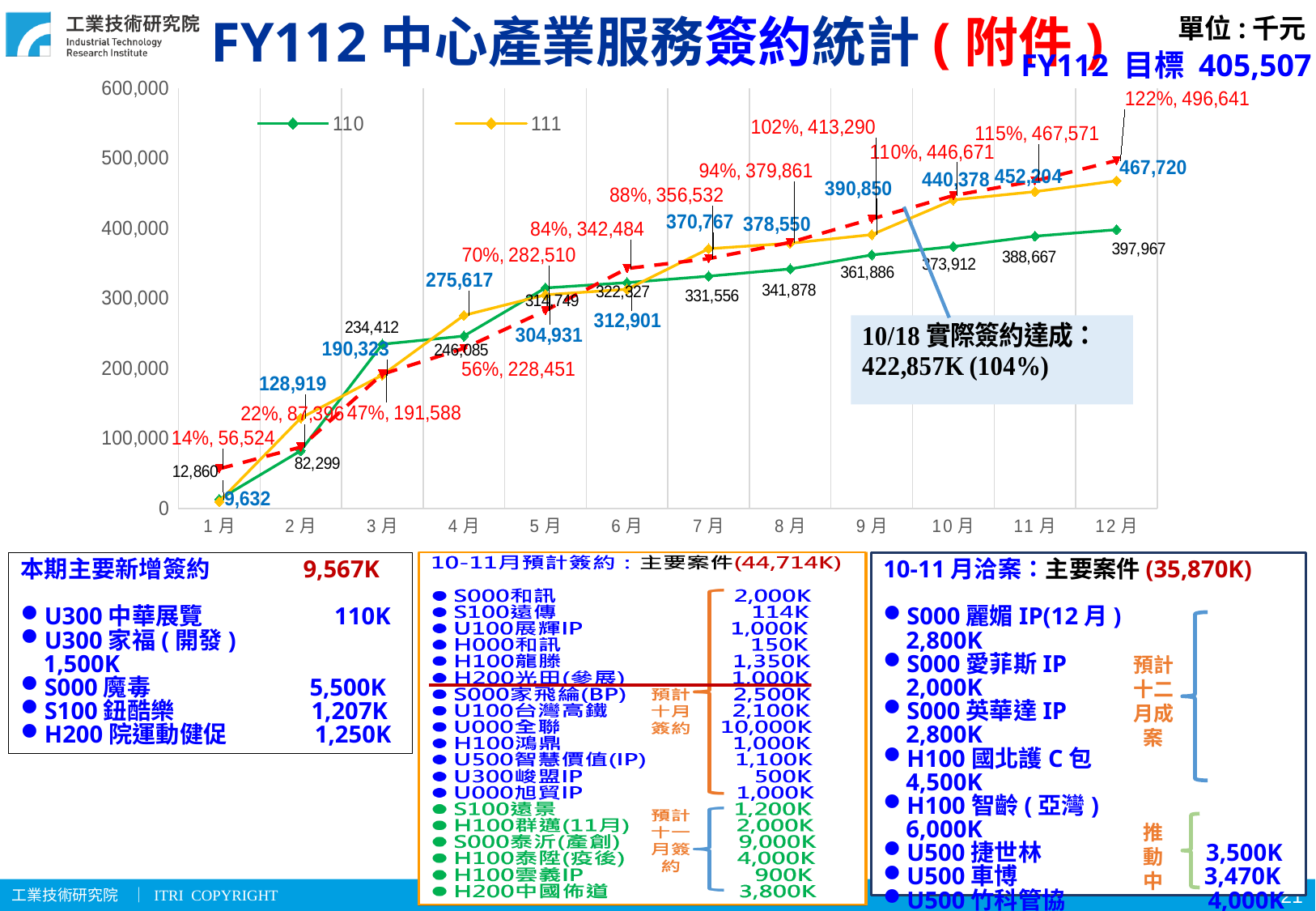
What is the difference between the 111 series and the 110 series at 12月? 69,753 How many series does the chart legend list? 2 In which month is the 111 series at its lowest? 1月 What is the value of the 110 series at 1月? 12,860 What is the value of the 111 series at 2月? 128,919 What is the value of the 110 series at 12月? 397,967 Does the 111 series rise or fall from 1月 to 12月? rise What kind of chart is shown on the slide? line chart What is the value of the 111 series at 12月? 467,720 In which month is the 110 series at its highest? 12月 How many months are plotted along the x axis of the chart? 12 At 3月, which series has the larger value, 110 or 111? 110